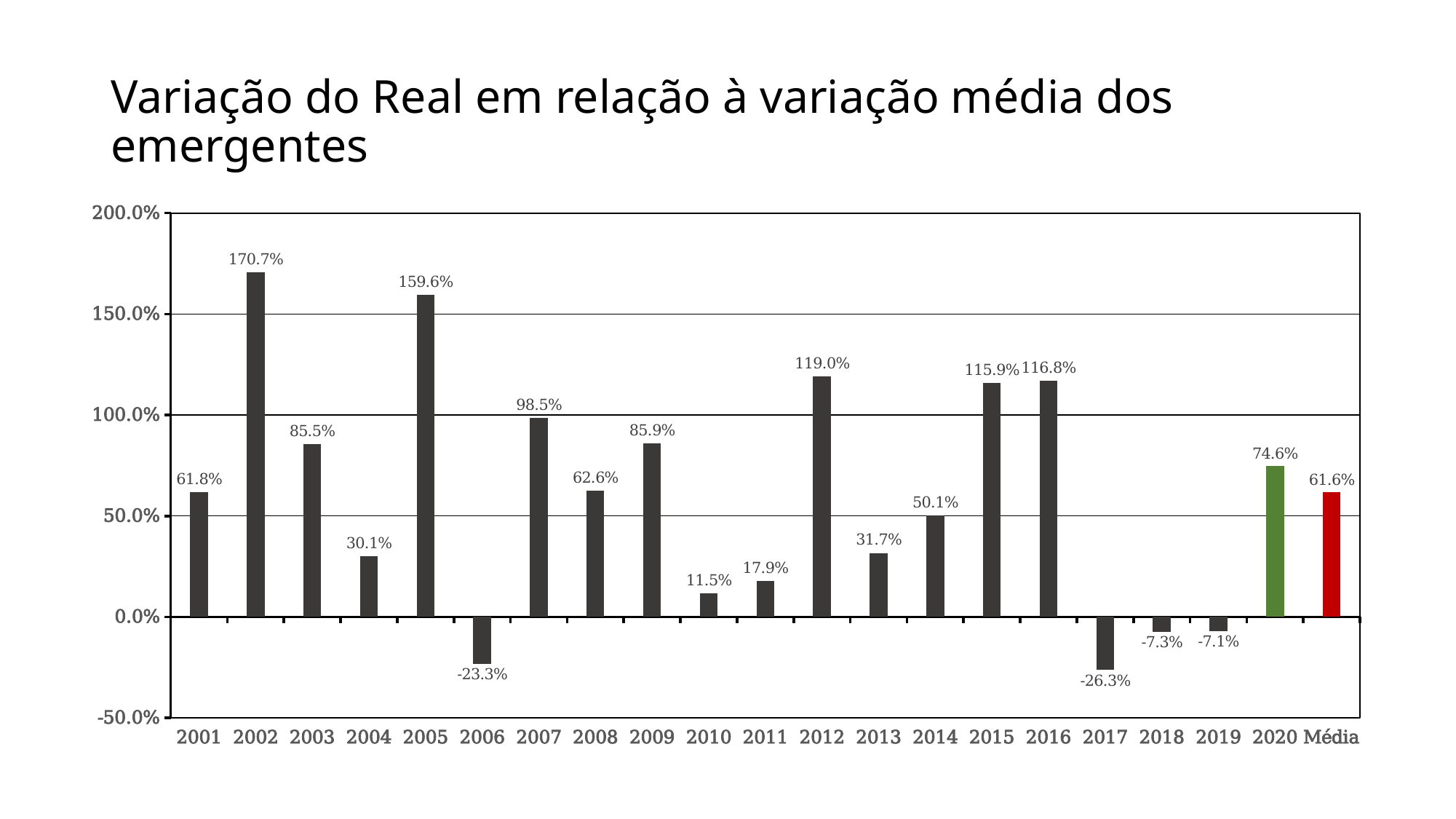
How many categories are shown on the x axis? 21 What colour is the bar for 2020? green What is the value for 2020? 74.6% Which category has the lowest value? 2017 What kind of chart is this? bar chart What is the difference between the values for 2002 and 2005? 11.1% What is the value for 2002? 170.7% Which is larger, the value for 2015 or the value for 2016? 2016 What is the value shown for Média? 61.6% Is the value for 2012 greater or less than 100.0%? greater How many categories have negative values? 4 Which category has the highest value? 2002